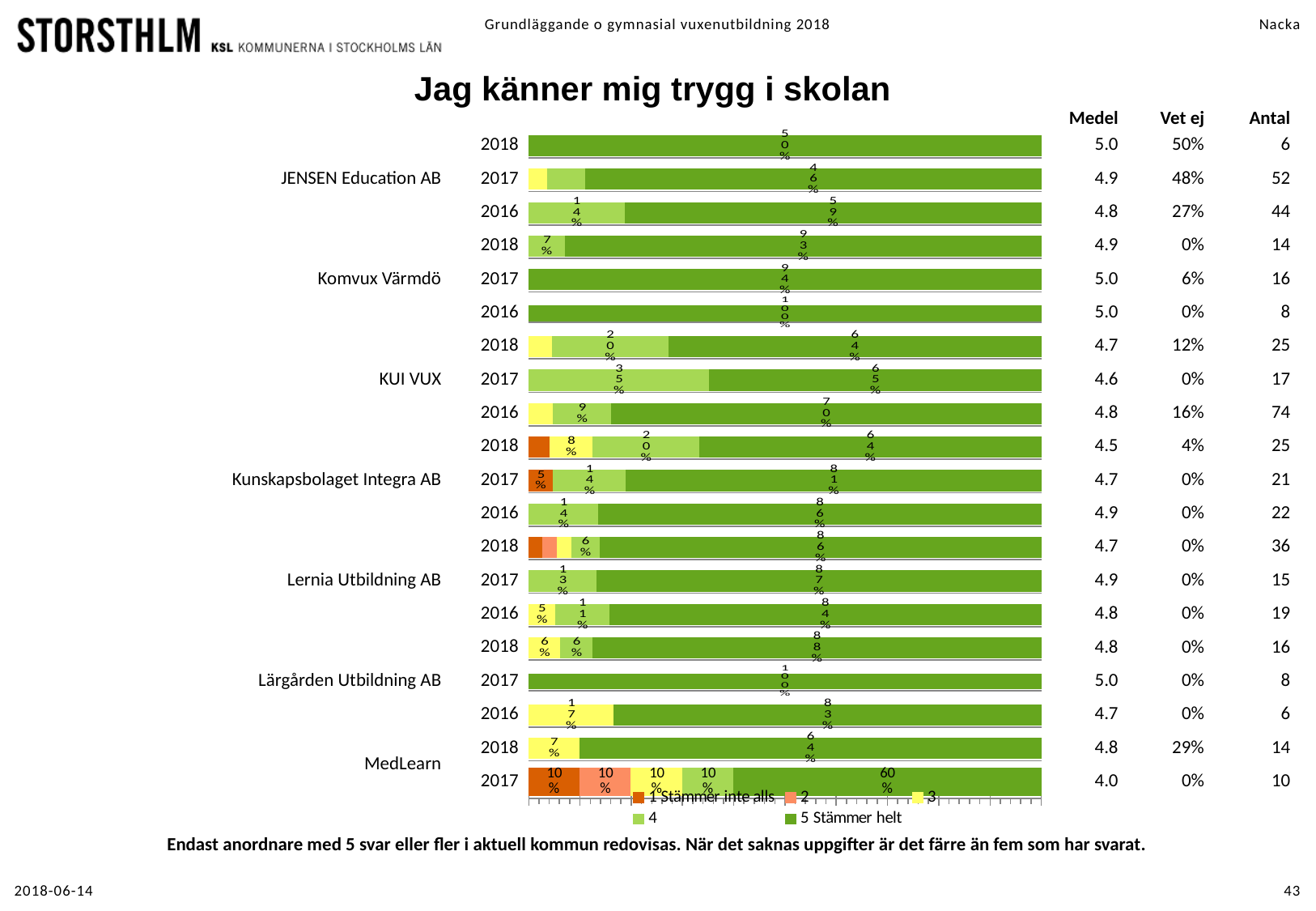
What kind of chart is shown on the slide? Stacked bar chart What is the data label for the '5 Stämmer helt' segment of the Komvux Värmdö 2016 bar? 100% What is the data label for the '4' segment of the KUI VUX 2017 bar? 35% Which legend entry corresponds to the dark green segments? 5 Stämmer helt What is the title of the chart? Jag känner mig trygg i skolan Which has a larger '5 Stämmer helt' share: Kunskapsbolaget Integra AB 2017 or Kunskapsbolaget Integra AB 2016? Kunskapsbolaget Integra AB 2016 In the MedLearn 2017 bar, what is the difference between the '5 Stämmer helt' segment and the '1 Stämmer inte alls' segment? 50 percentage points How many bars are plotted in the chart? 20 What is the data label for the '3' segment of the Lärgården Utbildning AB 2016 bar? 17% For Komvux Värmdö, does the '5 Stämmer helt' share rise or fall from 2016 to 2018? Fall How many series does the chart legend list? 5 What is the data label for the '5 Stämmer helt' segment of the MedLearn 2017 bar? 60%